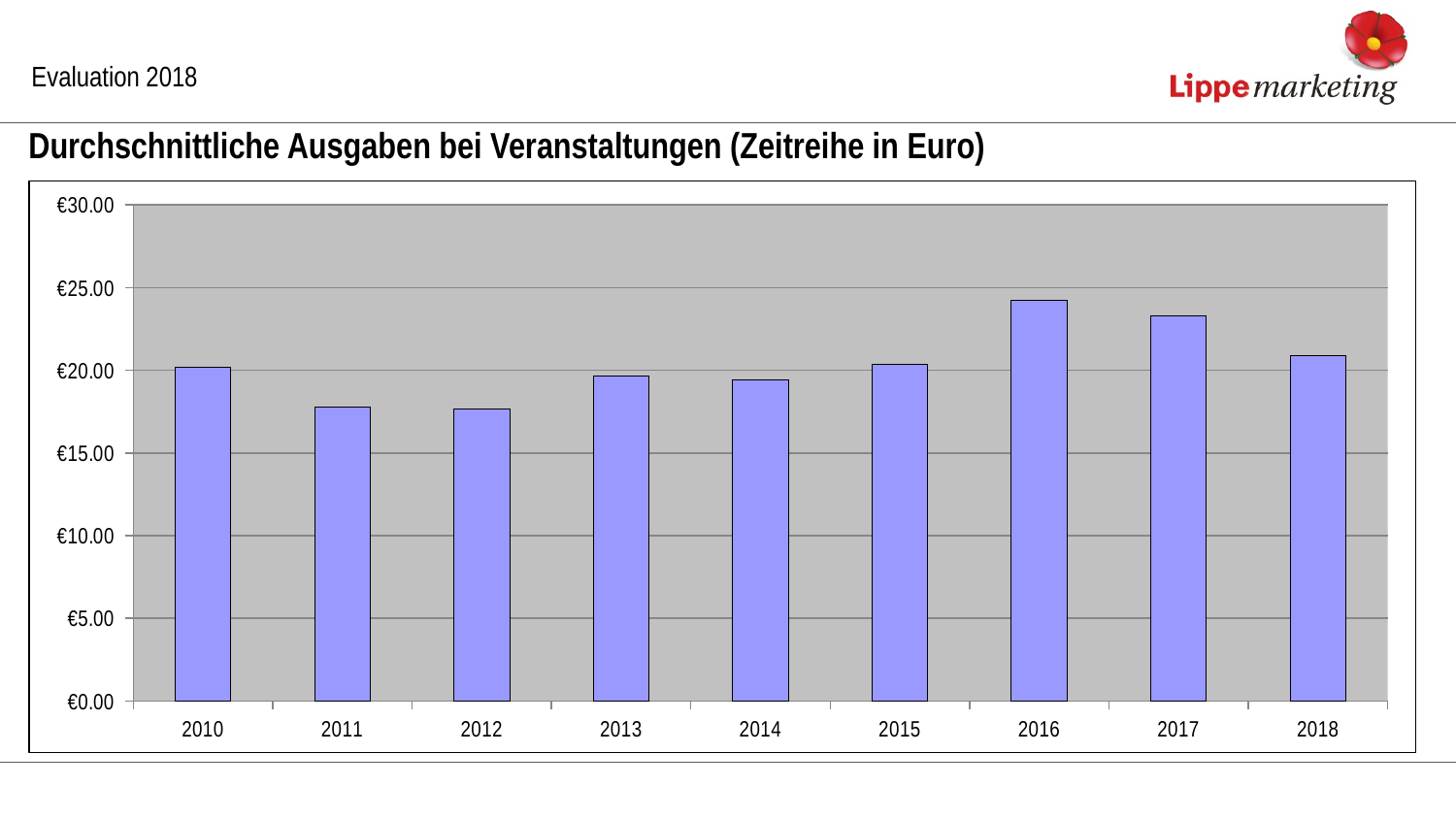
Is the value for 2017 greater or less than €20.00? greater How many years are shown on the x axis of the chart? 9 Which is larger, the value for 2016 or the value for 2018? 2016 Is the value for 2016 greater or less than €25.00? less Is the value for 2011 greater or less than €20.00? less Which is larger, the value for 2010 or the value for 2011? 2010 Which year has the highest average spending? 2016 What is the title of the chart? Durchschnittliche Ausgaben bei Veranstaltungen (Zeitreihe in Euro) Do the values rise or fall from 2012 to 2016? rise What kind of chart is shown on the slide? bar chart